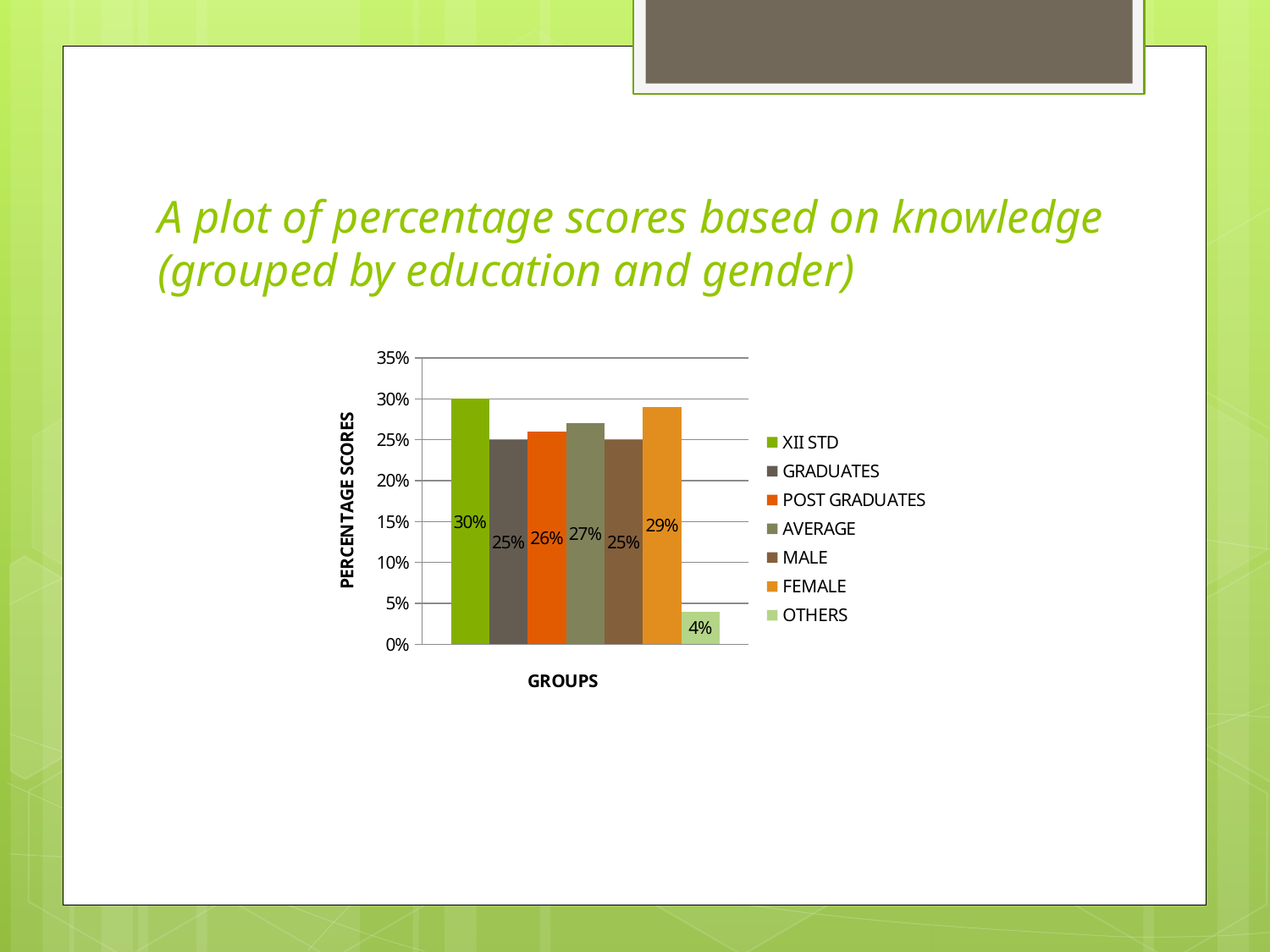
What is the label of the vertical axis? PERCENTAGE SCORES Which group has the highest percentage score? XII STD What kind of chart is shown on the slide? Bar chart How many series does the legend list? 7 What is the difference between the percentage scores for FEMALE and MALE? 4% What is the percentage score for FEMALE? 29% What is the percentage score for POST GRADUATES? 26% Which has a higher percentage score, AVERAGE or POST GRADUATES? AVERAGE What is the percentage score for XII STD? 30% What is the difference between the percentage scores for XII STD and GRADUATES? 5% Which group has the lowest percentage score? OTHERS What is the percentage score for OTHERS? 4%